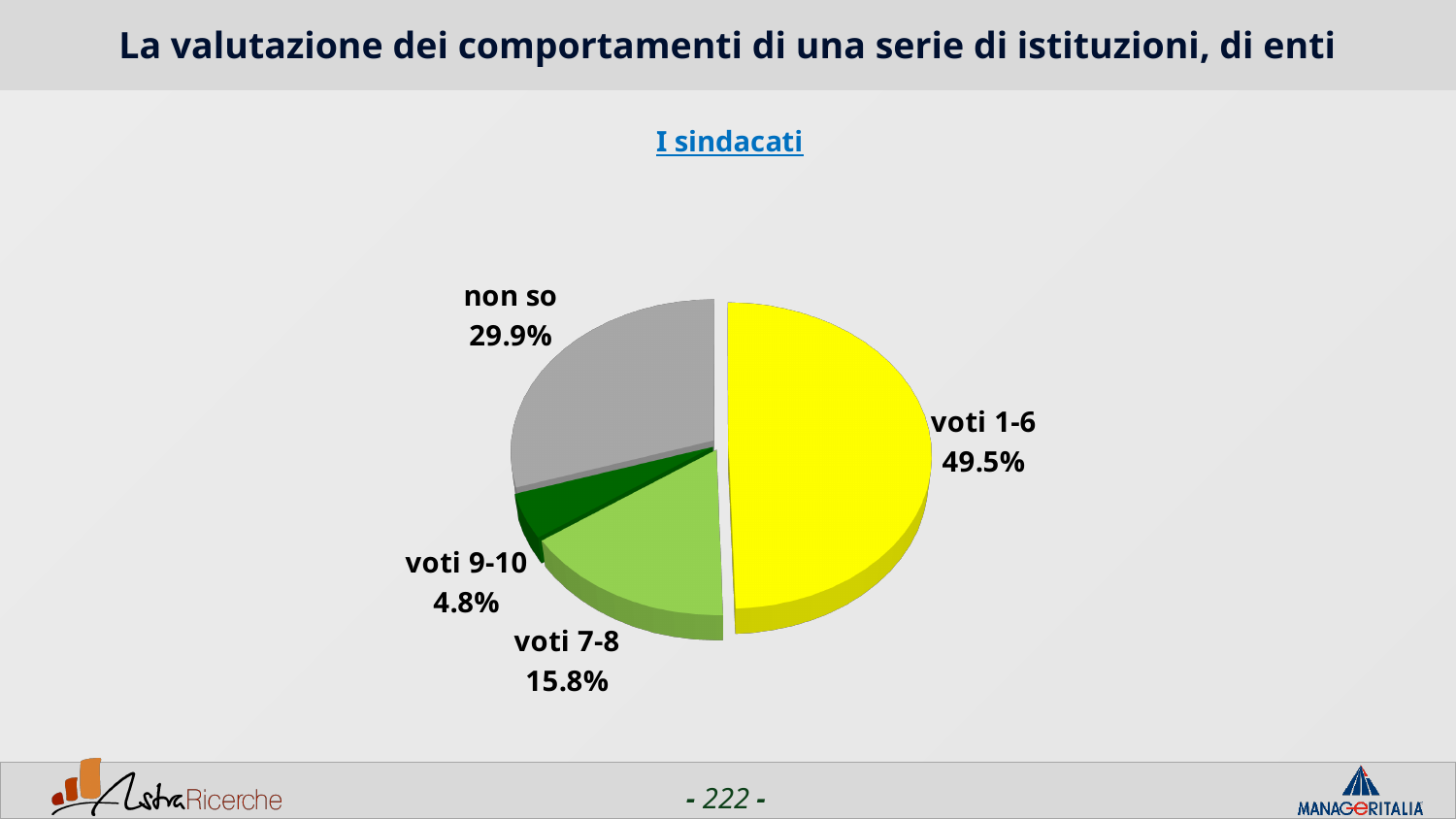
What percentage of the pie is labelled "non so"? 29.9% Which is larger, the "voti 7-8" slice or the "non so" slice? non so What kind of chart is shown on the slide? pie chart What percentage of the pie is labelled "voti 9-10"? 4.8% What is the combined percentage of the "voti 7-8" and "voti 9-10" slices? 20.6% How many slices does the pie chart have? 4 Which slice of the pie is the smallest? voti 9-10 What percentage of the pie is labelled "voti 1-6"? 49.5% What is the subtitle of the chart shown on the slide? I sindacati Which slice of the pie is the largest? voti 1-6 What is the difference in percentage points between the "voti 1-6" slice and the "non so" slice? 19.6 What percentage of the pie is labelled "voti 7-8"? 15.8%